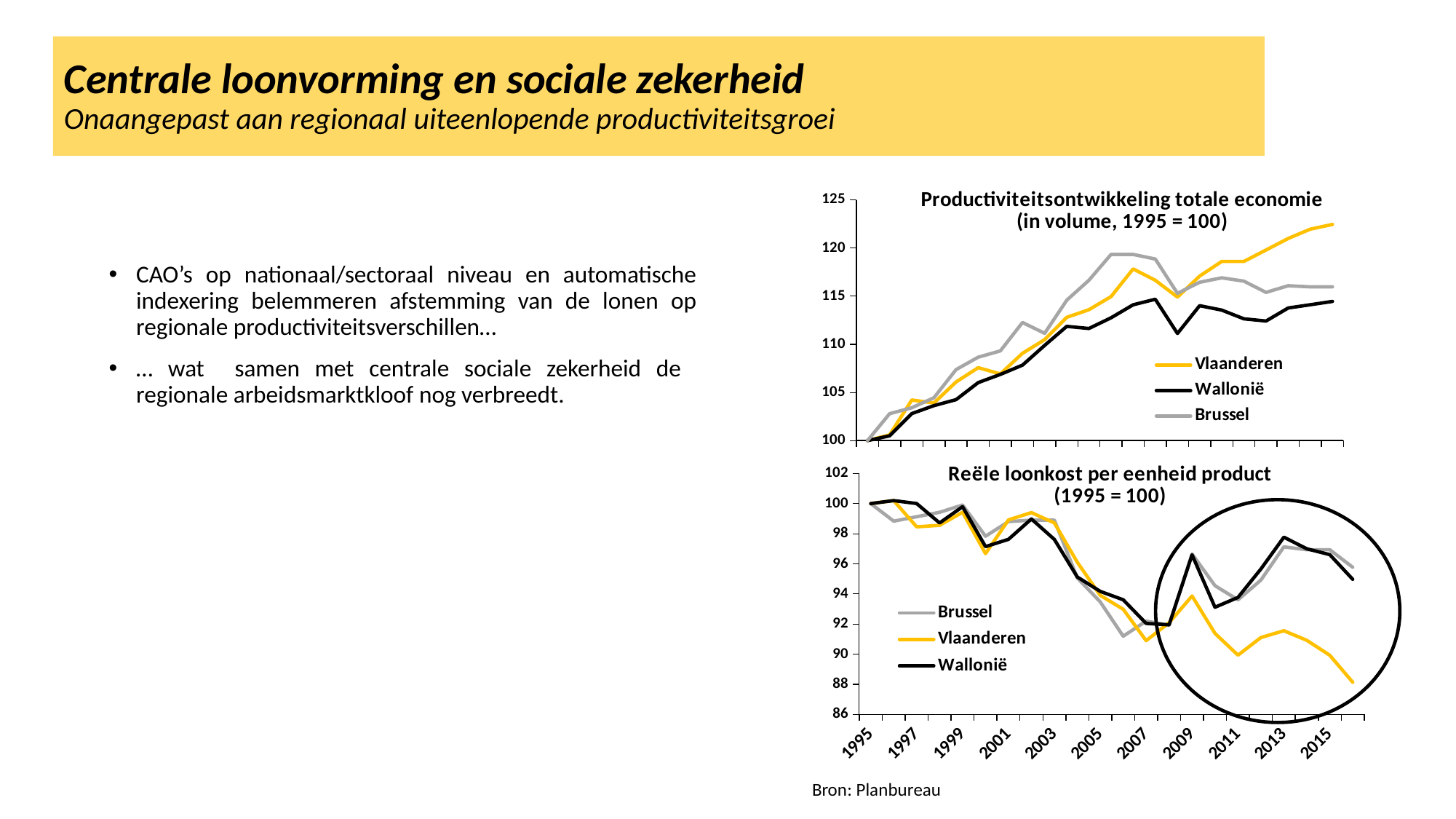
In the bottom chart, 'Reële loonkost per eenheid product', is the value for Vlaanderen in 2016 greater or less than 90? less In the top chart, 'Productiviteitsontwikkeling totale economie', is the value for Wallonië in 2016 greater or less than 120? less In the top chart, 'Productiviteitsontwikkeling totale economie', does the Vlaanderen series overall rise or fall from 1995 to 2016? Rise In the bottom chart, 'Reële loonkost per eenheid product', which is larger in 2016: Vlaanderen or Wallonië? Wallonië In the top chart, 'Productiviteitsontwikkeling totale economie', which is larger in 2016: Vlaanderen or Wallonië? Vlaanderen In the bottom chart, 'Reële loonkost per eenheid product', does the Vlaanderen series overall rise or fall from 1995 to 2016? Fall What kind of chart is the top chart, 'Productiviteitsontwikkeling totale economie'? Line chart In the top chart, 'Productiviteitsontwikkeling totale economie', which series is highest at the end of the period (2016)? Vlaanderen How many series does the legend of the bottom chart, 'Reële loonkost per eenheid product', list? 3 What colour is the Vlaanderen line in the charts? Yellow In the top chart, 'Productiviteitsontwikkeling totale economie', is the value for Vlaanderen in 2016 greater or less than 120? greater In the bottom chart, 'Reële loonkost per eenheid product', which series is lowest at the end of the period (2016)? Vlaanderen